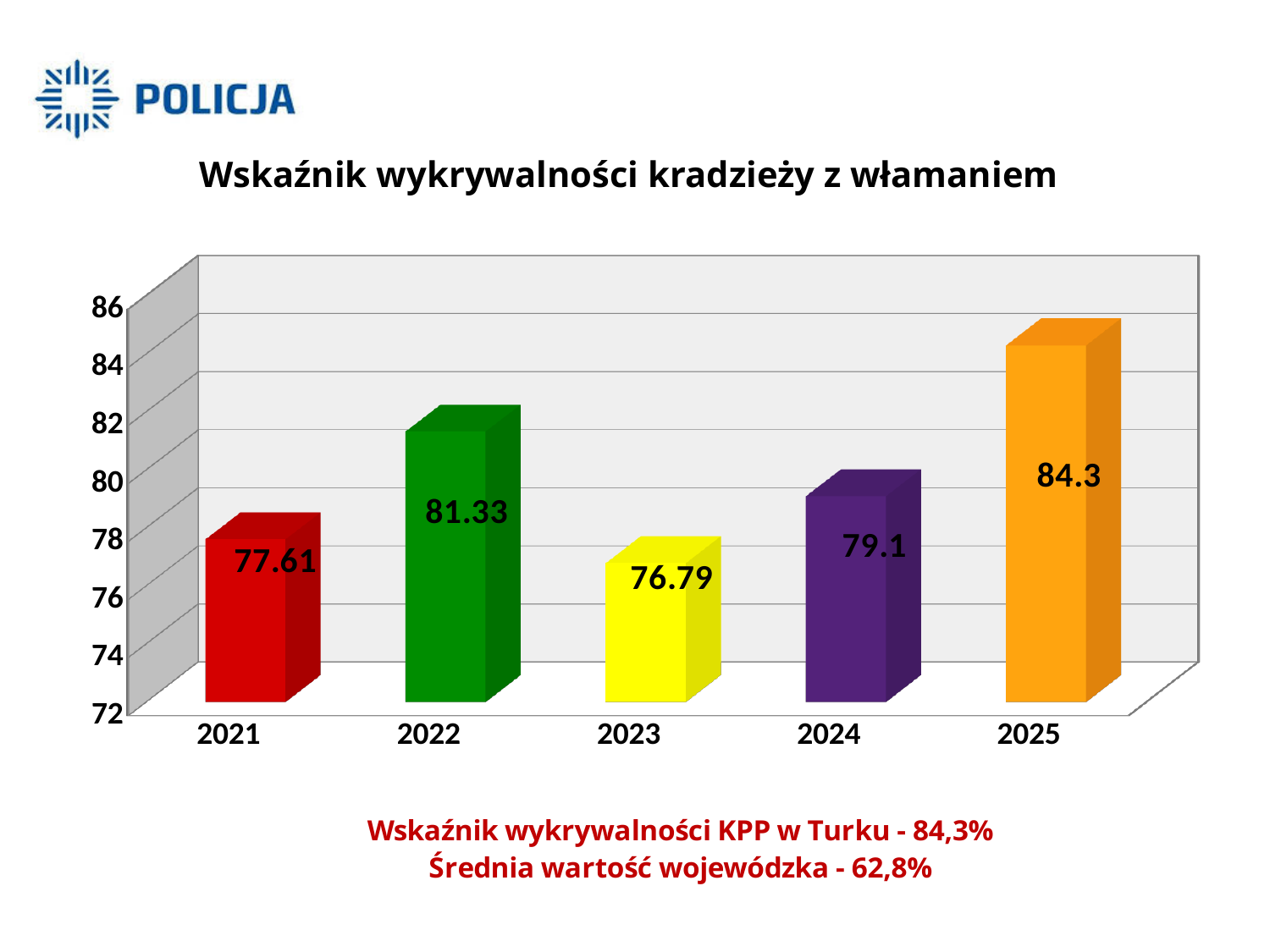
What kind of chart is shown on the slide? bar chart What is the title of the chart? Wskaźnik wykrywalności kradzieży z włamaniem What is the value for 2023? 76.79 Is the value for 2025 greater or less than 82? greater What is the difference between the values for 2025 and 2024? 5.2 Which year has the lowest value? 2023 How many years are shown on the chart? 5 What is the difference between the values for 2022 and 2021? 3.72 Which year has the highest value? 2025 What is the value for 2025? 84.3 What is the value for 2021? 77.61 Which is larger, the value for 2022 or the value for 2024? 2022